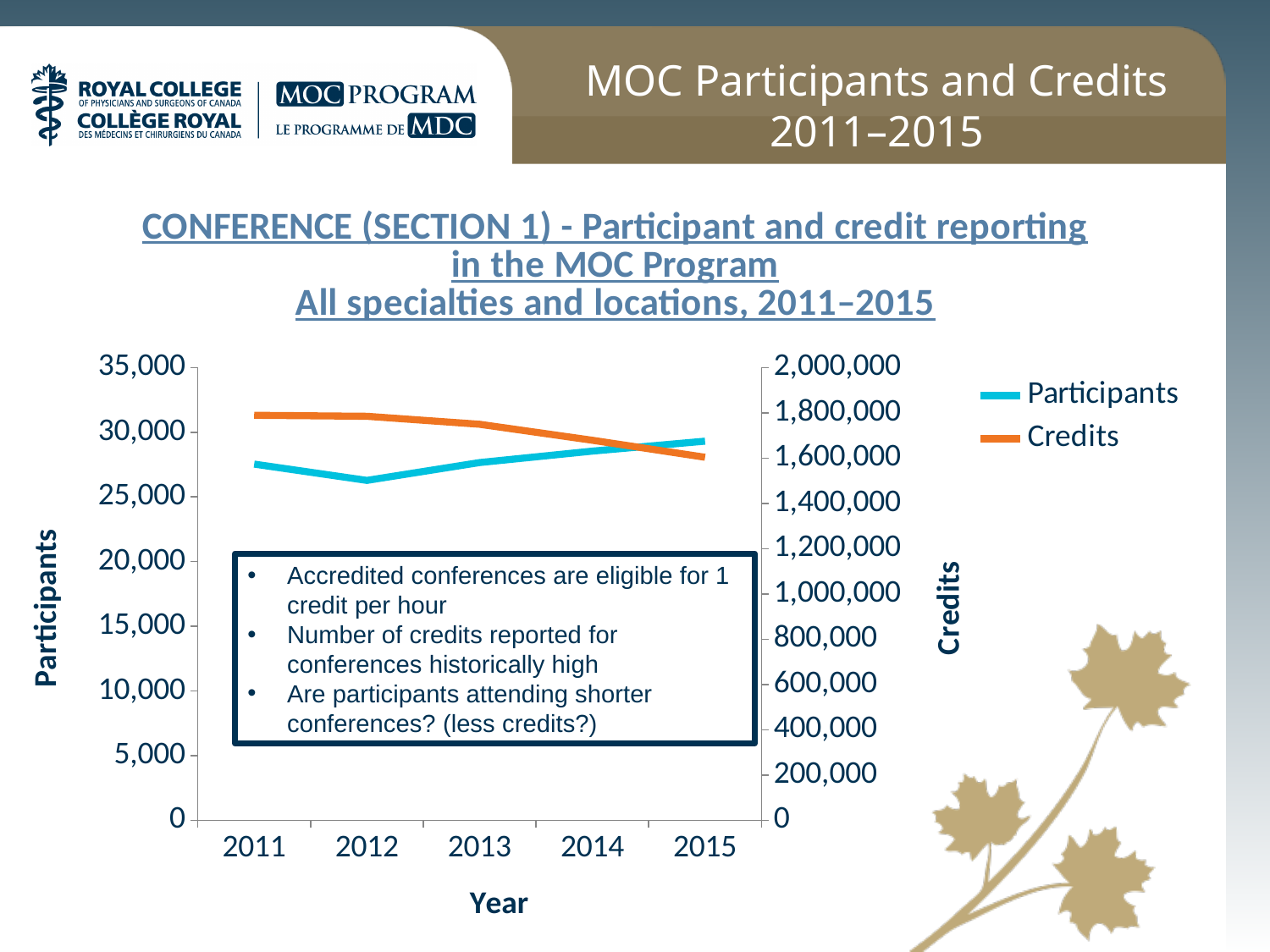
Is the Participants value for 2011 greater or less than 25,000? greater Do the Credits values rise or fall from 2011 to 2015? Fall Is the Credits value for 2011 greater or less than 1,600,000? greater In which year is the Participants line at its lowest? 2012 How many years are plotted along the x axis of the chart? 5 How many series does the chart legend list? 2 What kind of chart is shown on the slide? Line chart Which series is plotted in orange? Credits Is the Credits value for 2015 greater or less than 1,400,000? greater What is the title of the x axis of the chart? Year In which year is the Credits line at its lowest? 2015